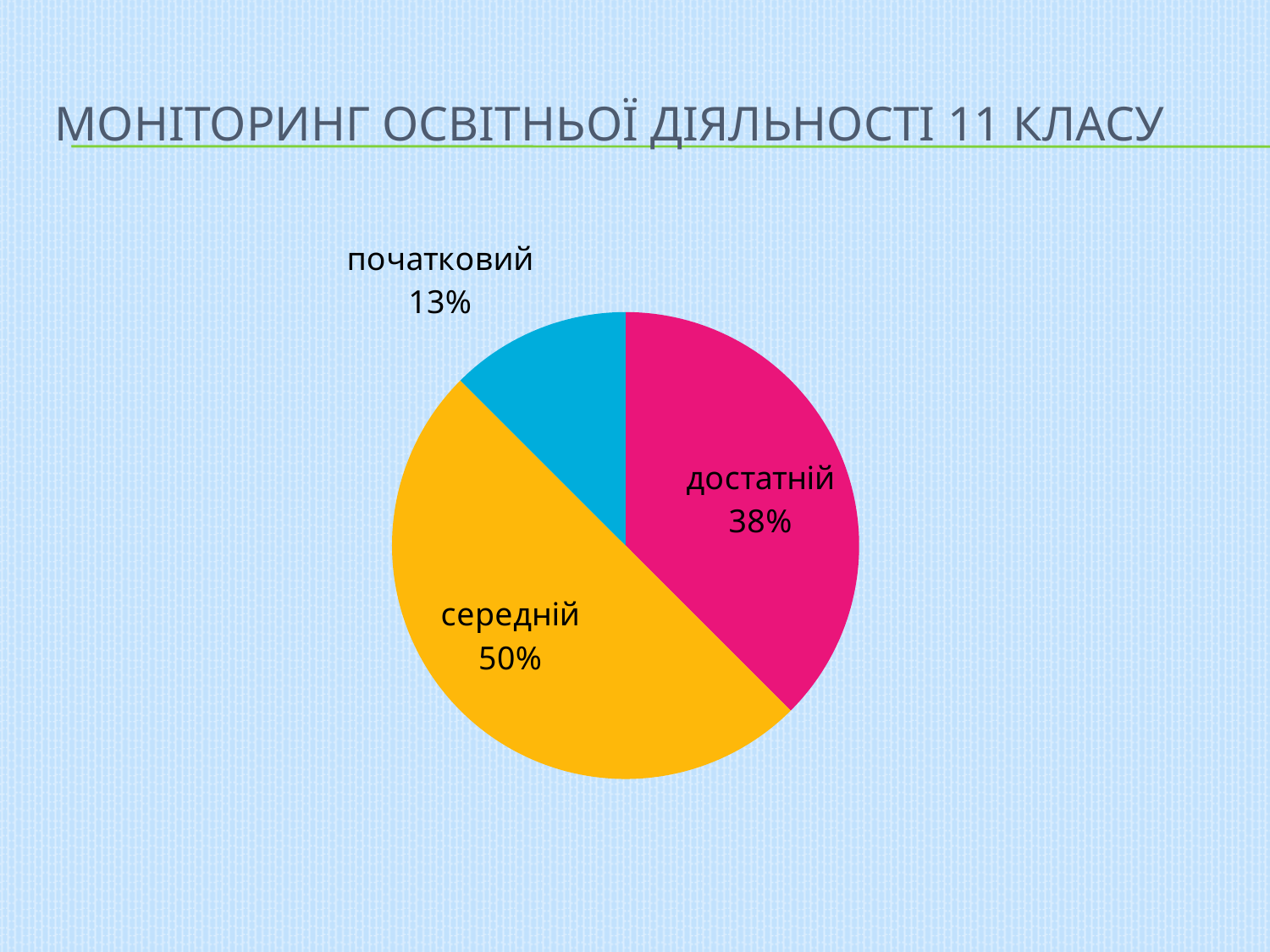
What is the title of the slide containing the pie chart? МОНІТОРИНГ ОСВІТНЬОЇ ДІЯЛЬНОСТІ 11 КЛАСУ What share of the pie does the "середній" slice represent? 50% Which category has the smallest slice of the pie? початковий What colour is the "середній" slice of the pie? yellow What kind of chart is shown on the slide? pie chart What is the difference in percentage points between the "достатній" and "початковий" slices? 25 What share of the pie does the "достатній" slice represent? 38% What share of the pie does the "початковий" slice represent? 13% Which slice is larger, "достатній" or "початковий"? достатній How many slices does the pie chart have? 3 What is the difference in percentage points between the "середній" and "достатній" slices? 12 Which category has the largest slice of the pie? середній